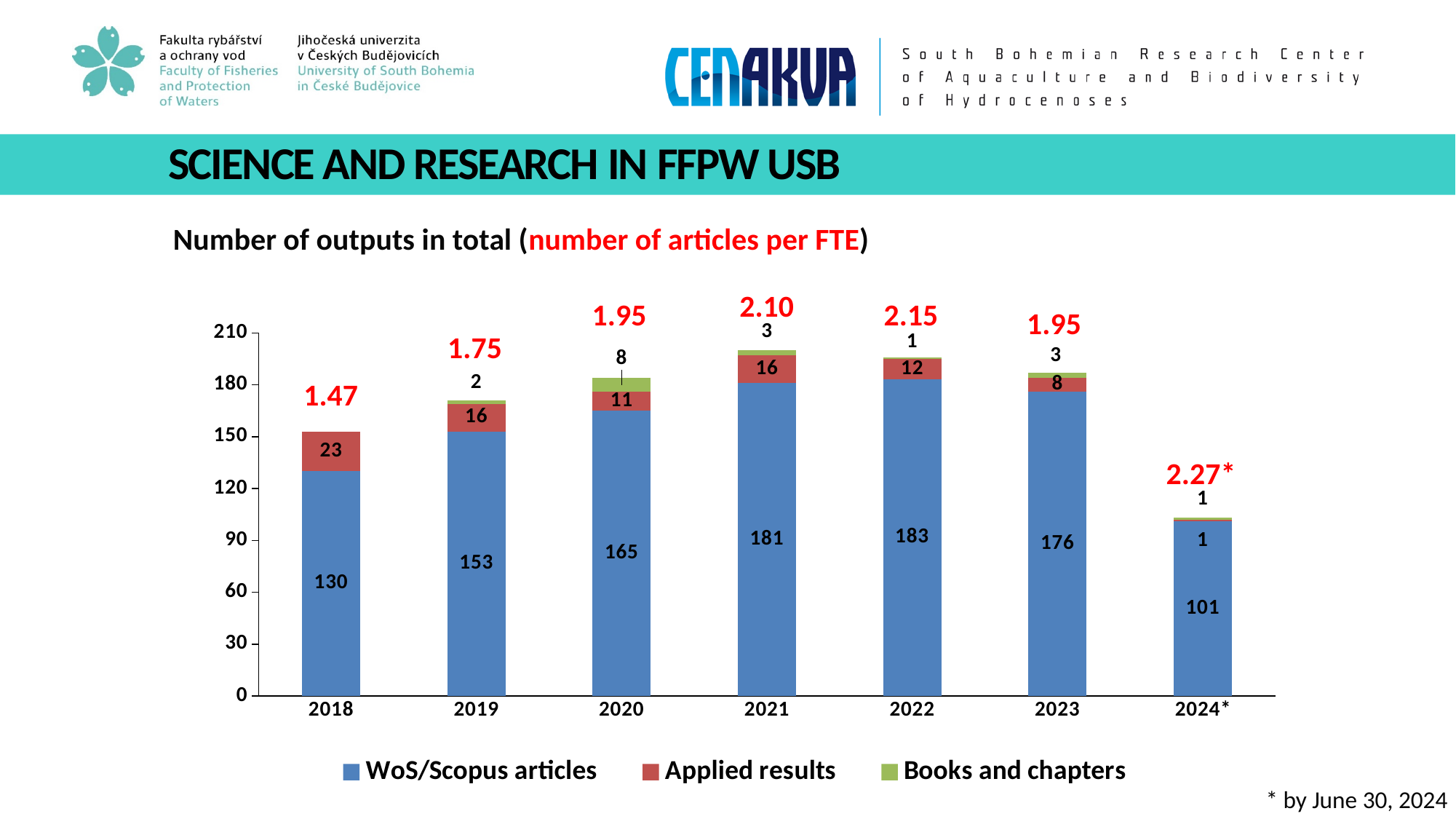
How many WoS/Scopus articles are shown for 2022? 183 What is the value for Applied results in 2018? 23 Which year has the highest value for Books and chapters? 2020 Is the total bar for 2024* greater or less than 90? greater How many series does the legend list? 3 Which year has the lowest number of WoS/Scopus articles? 2024* What is the number of articles per FTE shown above the 2021 bar? 2.10 What is the difference in WoS/Scopus articles between 2022 and 2018? 53 How many years are shown on the x axis? 7 What kind of chart is shown on the slide? Stacked bar chart Which year has the highest number of WoS/Scopus articles? 2022 What is the total of the stacked bar for 2021? 200